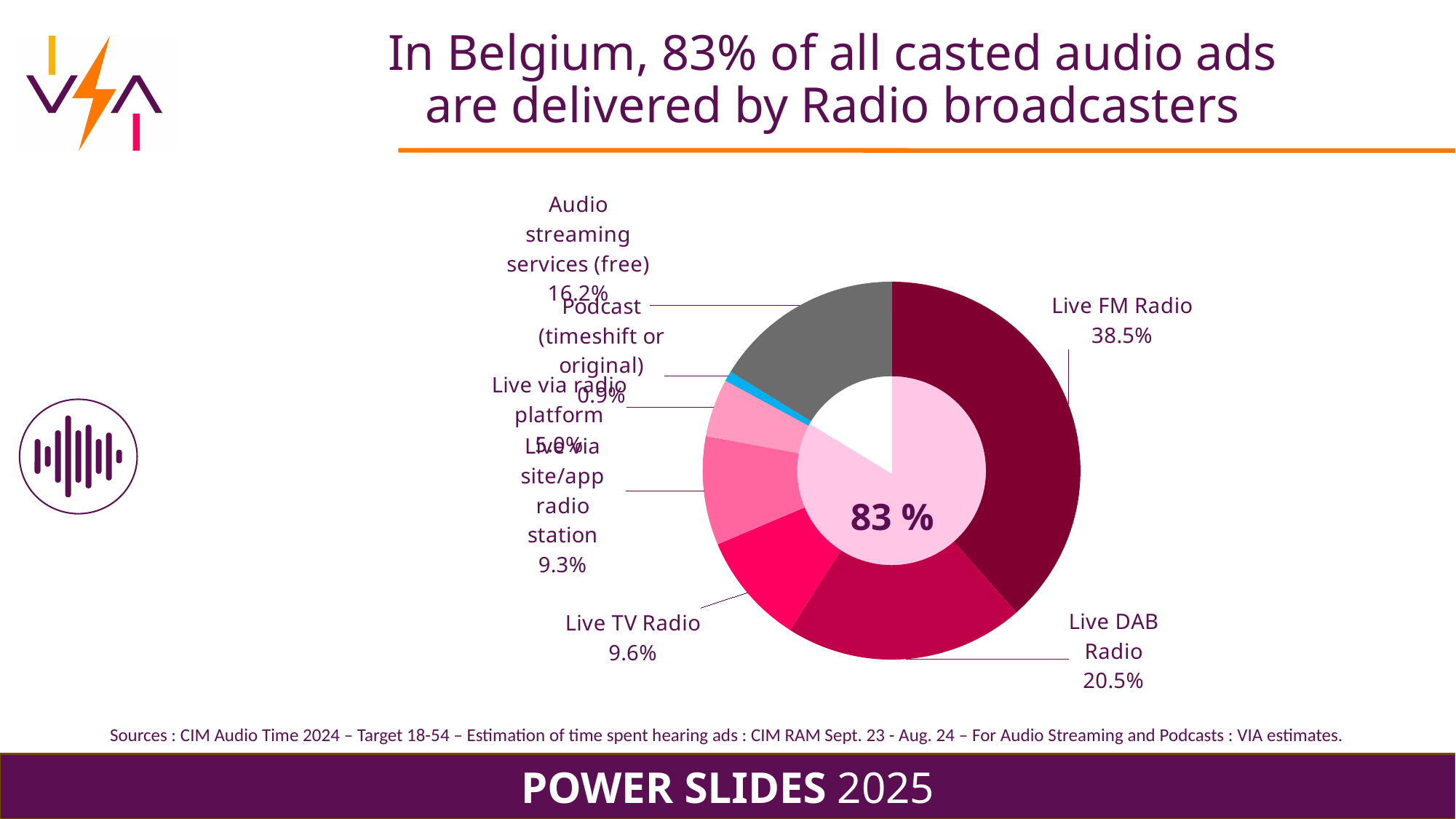
What share of casted audio ads is delivered by Live FM Radio? 38.5% Which has a larger share, Audio streaming services (free) or Live DAB Radio? Live DAB Radio What share of casted audio ads is delivered by Live TV Radio? 9.6% How many categories are shown in the chart? 7 Which category has the largest share of casted audio ads? Live FM Radio Which category has the smallest share of casted audio ads? Podcast (timeshift or original) How many percentage points larger is the Live FM Radio share than the Live DAB Radio share? 18.0 percentage points What share of casted audio ads is delivered by Podcast (timeshift or original)? 0.9% What share of casted audio ads is delivered by Audio streaming services (free)? 16.2% What share of casted audio ads is delivered by Live via site/app radio station? 9.3% What type of chart is shown on the slide? Doughnut chart What share of casted audio ads is delivered by Live DAB Radio? 20.5%